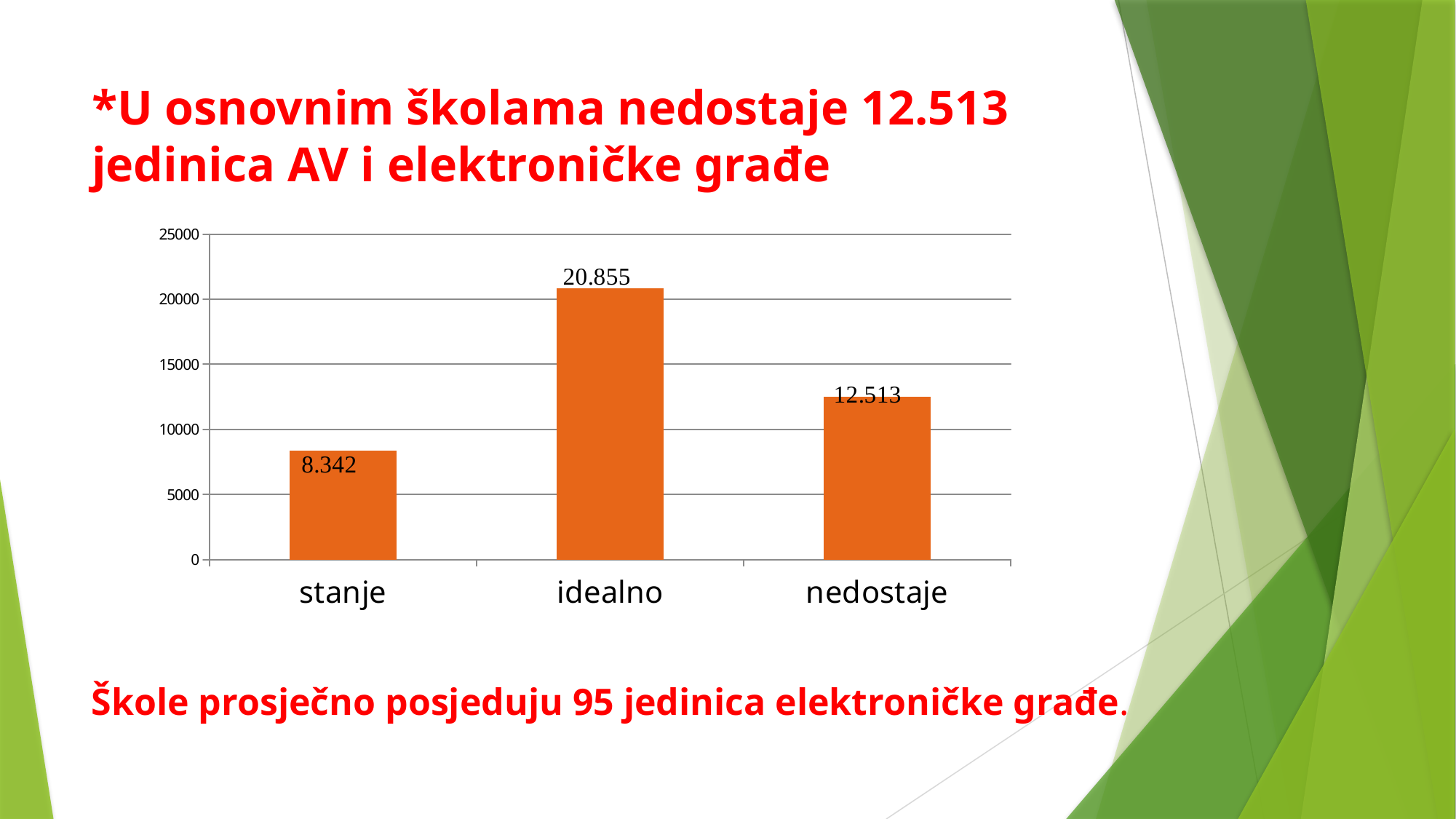
What is the difference between the values for "nedostaje" and "stanje"? 4.171 Which is larger, the value for "nedostaje" or the value for "stanje"? nedostaje Which category has the highest value? idealno Which category has the lowest value? stanje What kind of chart is shown on the slide? bar chart How many categories are shown on the x axis? 3 What is the value for "idealno"? 20.855 Is the value for "stanje" greater or less than 10000? less What is the value for "stanje"? 8.342 Is the value for "idealno" greater or less than 20000? greater What is the value for "nedostaje"? 12.513 What is the difference between the values for "idealno" and "stanje"? 12.513